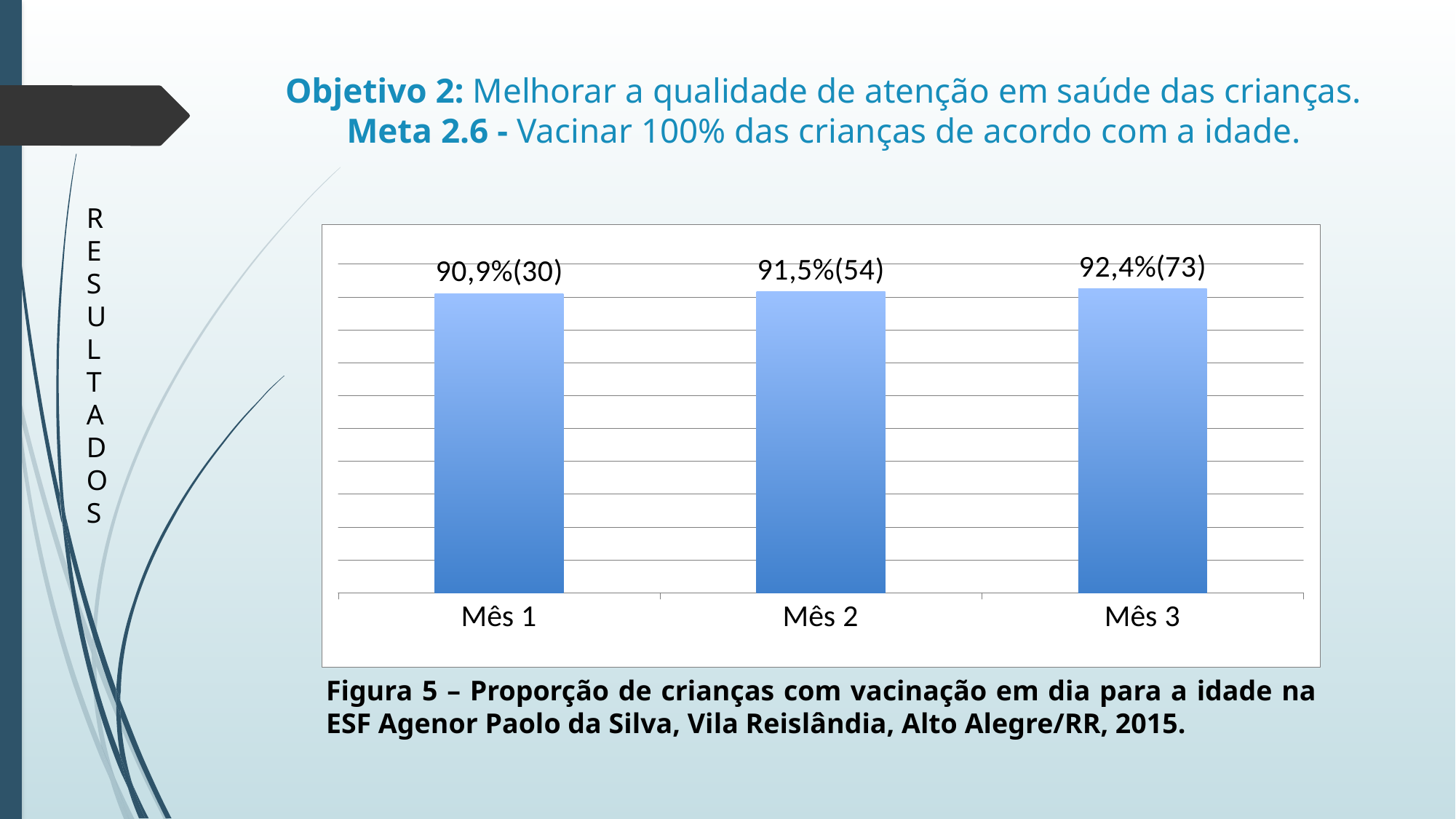
Which is larger, the percentage for Mês 2 or for Mês 1? Mês 2 Which month has the highest percentage? Mês 3 What is the data label shown for Mês 3? 92,4%(73) What is the data label shown for Mês 1? 90,9%(30) What percentage is shown for Mês 3? 92,4% What is the difference in percentage points between Mês 3 and Mês 1? 1,5 Which month has the lowest percentage? Mês 1 What kind of chart is shown on the slide? Bar chart How many months (categories) are shown on the x axis? 3 How many children are shown in parentheses for Mês 2? 54 What is the data label shown for Mês 2? 91,5%(54) How many more children are counted in Mês 3 than in Mês 1? 43